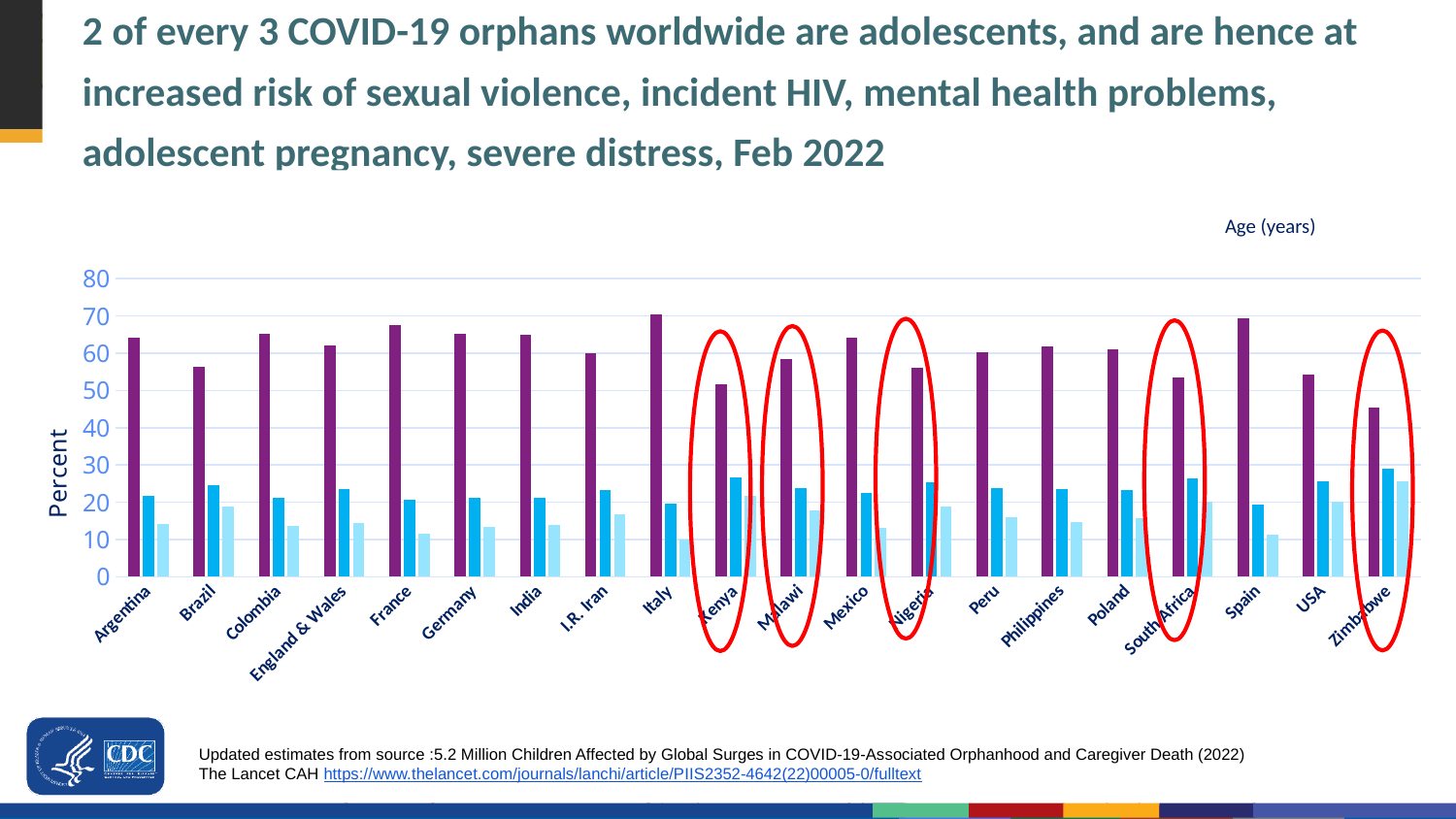
Is the purple bar for Zimbabwe greater or less than 50? less Is the purple bar for Kenya greater or less than 60? less Is the medium blue bar for Zimbabwe greater or less than 20? greater Which has the taller purple bar, Argentina or Brazil? Argentina How many countries are shown on the x axis of the chart? 20 What is the label on the vertical axis of the chart? Percent Which country has the lowest purple bar on the chart? Zimbabwe What kind of chart is shown on the slide? bar chart Which has the taller purple bar, Mexico or Zimbabwe? Mexico How many countries on the chart are circled in red? 5